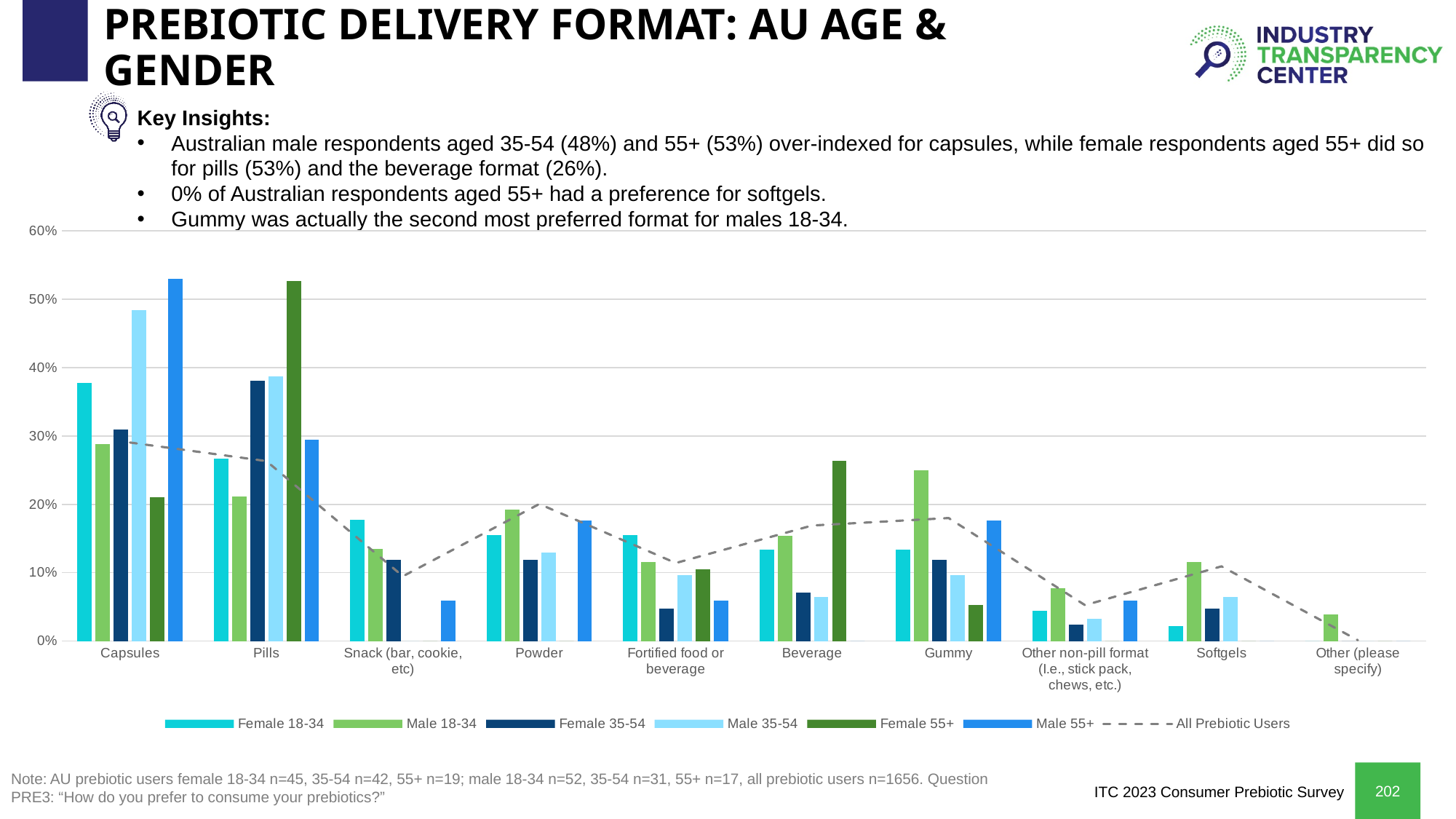
Is the value for Female 18-34 in the Capsules category greater or less than 30%? greater Which series has the highest bar in the Gummy category? Male 18-34 Is the value for Male 55+ in the Gummy category greater or less than 20%? less Which series has the lowest bar in the Capsules category? Female 55+ How many series does the legend list? 7 In the Capsules category, which is larger: Female 18-34 or Male 18-34? Female 18-34 Which series has the highest bar in the Capsules category? Male 55+ Which series has the highest bar in the Beverage category? Female 55+ How many delivery format categories are shown on the x axis? 10 Which series is represented by the dashed grey line? All Prebiotic Users What kind of chart is shown on the slide? Bar chart (with a dashed line for All Prebiotic Users)